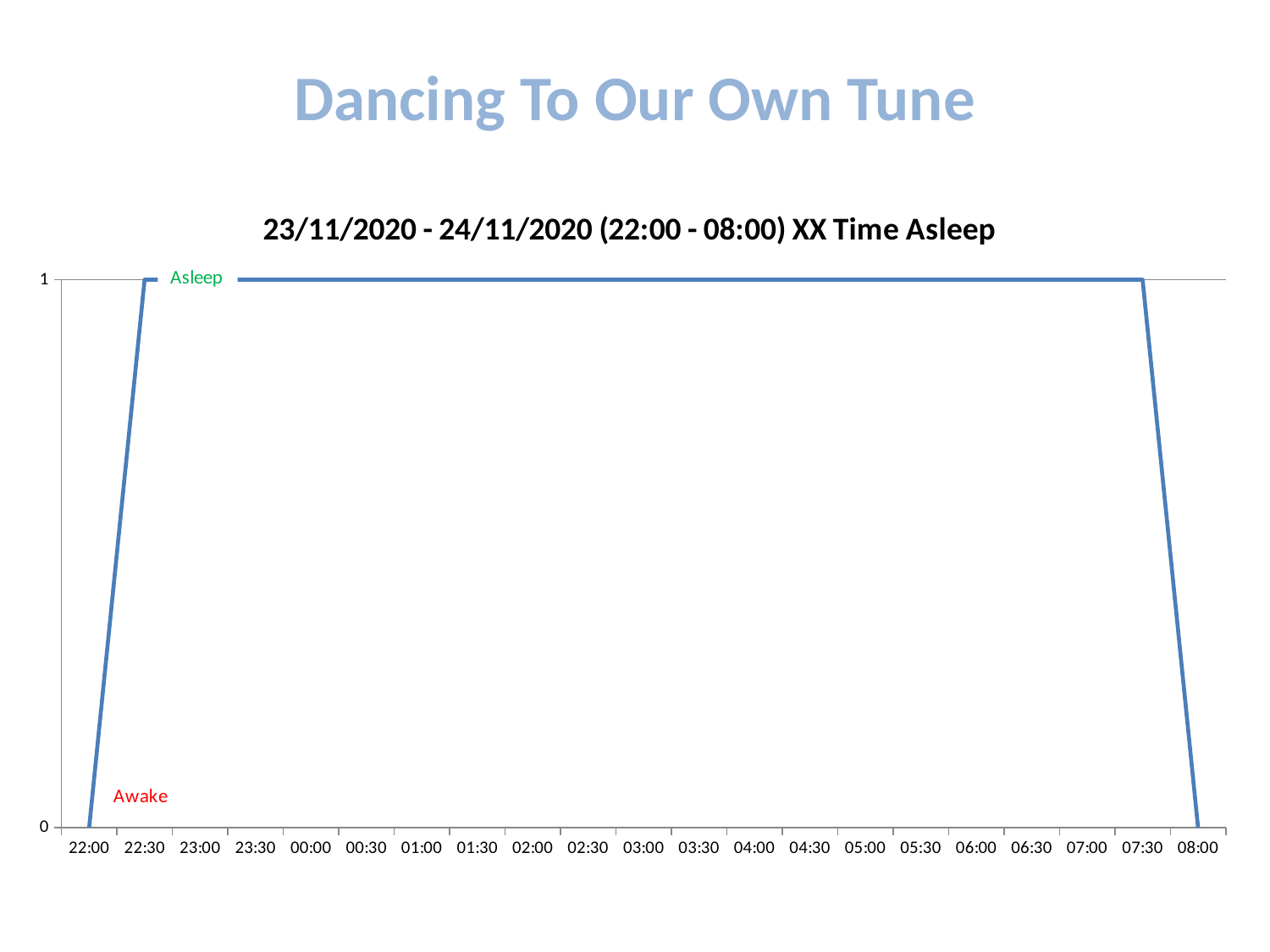
Which has the larger value, 22:00 or 00:00? 00:00 What is the value of the line at 07:30? 1 What is the value of the line at 22:00? 0 What is the highest value the line reaches? 1 Does the line rise or fall between 22:00 and 22:30? rise What label is shown in green next to the top of the line? Asleep How many time points are labelled on the x axis? 21 What kind of chart is shown on the slide? line chart What is the value of the line at 08:00? 0 What is the title of the chart? 23/11/2020 - 24/11/2020 (22:00 - 08:00) XX Time Asleep Does the line rise or fall between 07:30 and 08:00? fall What is the value of the line at 03:00? 1